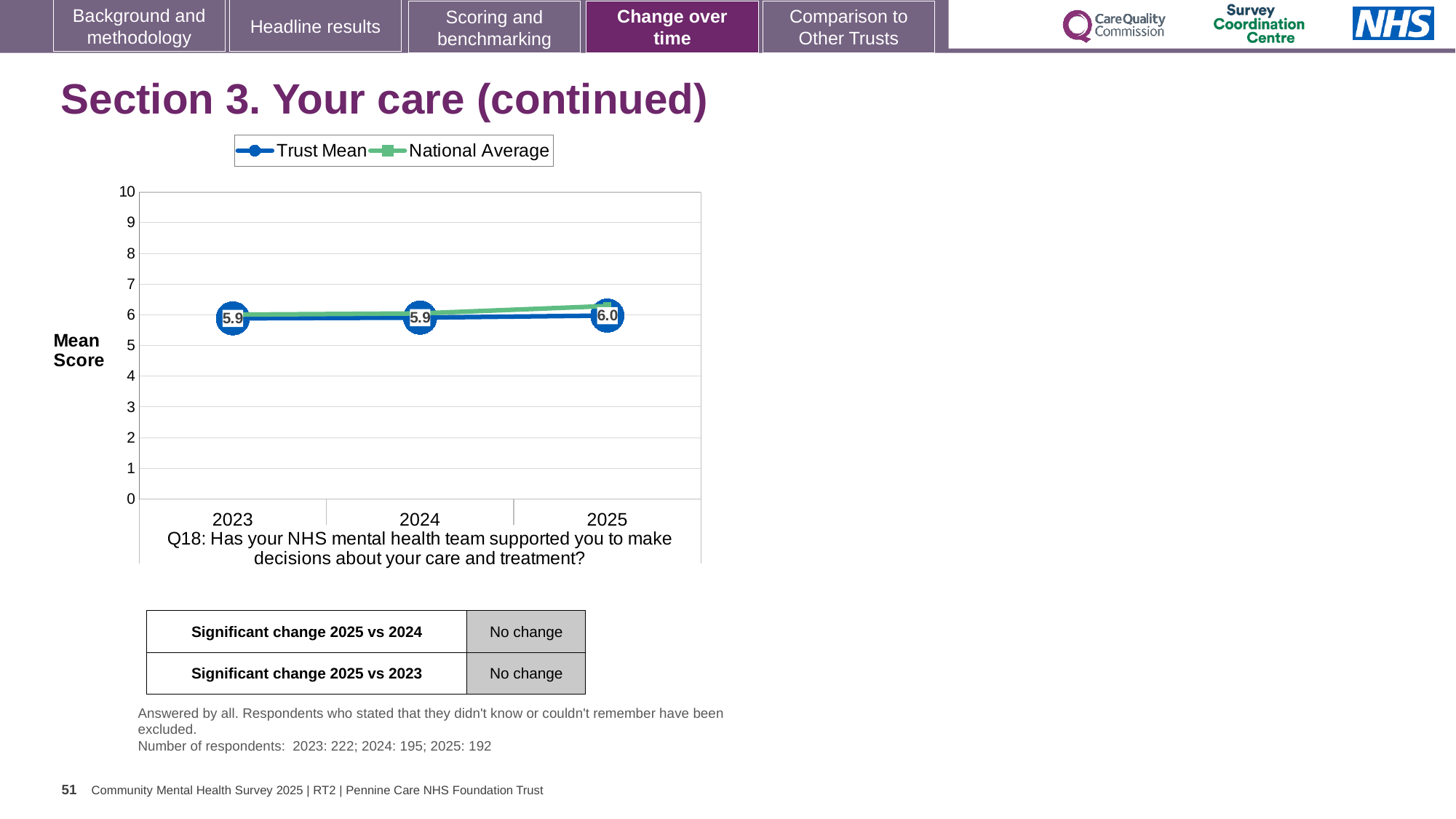
Which is larger, the Trust Mean score for 2025 or for 2024? 2025 What kind of chart is shown on the slide? Line chart What is the difference between the Trust Mean score in 2025 and in 2023? 0.1 What is the label of the y axis of the chart? Mean Score In which year is the Trust Mean score highest? 2025 What is the Trust Mean score for 2025? 6.0 How many series does the chart legend list? 2 How many years are plotted on the x axis of the chart? 3 What is the Trust Mean score for 2023? 5.9 Is the National Average value for 2025 greater or less than 5? greater What is the Trust Mean score for 2024? 5.9 Is the National Average value for 2023 greater or less than 7? less